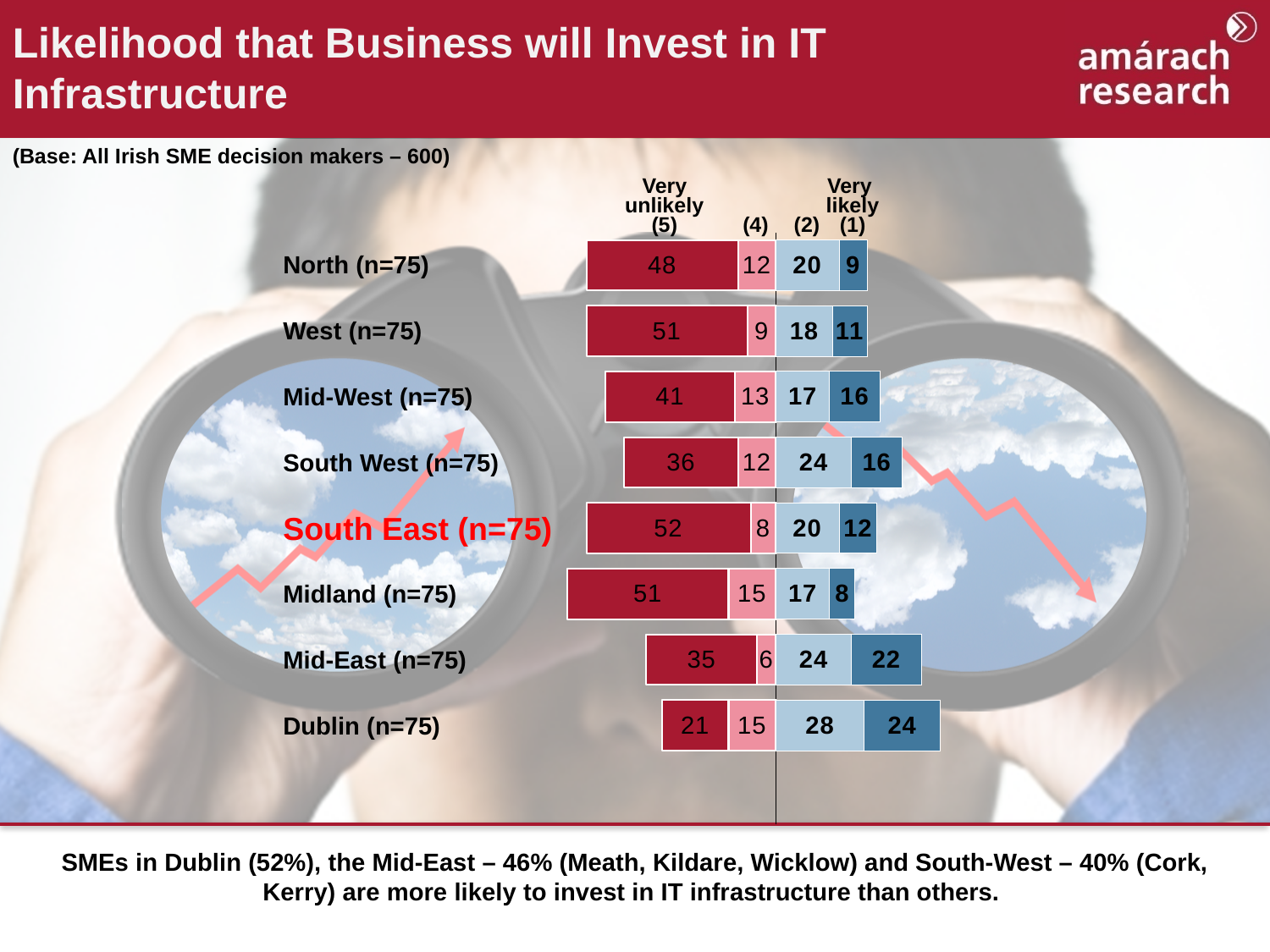
Which region has the highest 'Very unlikely (5)' value? South East (n=75) Which is larger: the 'Very likely (1)' value for Mid-East (n=75) or for South West (n=75)? Mid-East (n=75) Which region has the lowest 'Very unlikely (5)' value? Dublin (n=75) How many regions are shown in the chart? 8 How many response categories are shown in the chart header? 4 What is the 'Very unlikely (5)' value for North (n=75)? 48 What is the '(2)' value for Mid-East (n=75)? 24 What is the 'Very likely (1)' value for Dublin (n=75)? 24 What kind of chart is shown on the slide? Stacked bar chart Which region has the lowest 'Very likely (1)' value? Midland (n=75) What is the difference between the 'Very unlikely (5)' values for South East (n=75) and Dublin (n=75)? 31 What is the base stated for the chart? All Irish SME decision makers – 600